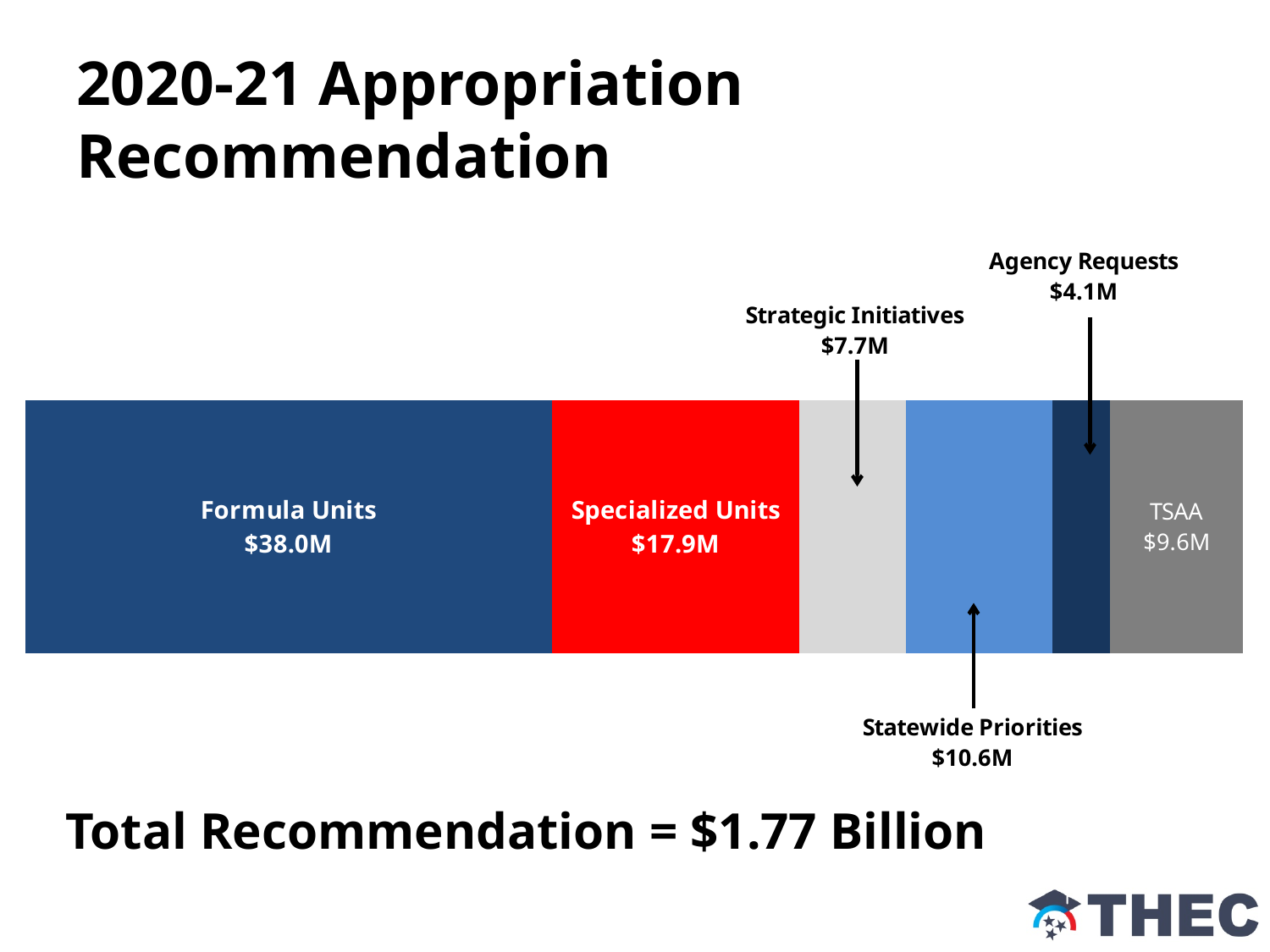
What is the value shown for TSAA? $9.6M What is the value shown for Specialized Units? $17.9M How many segments make up the bar? 6 What kind of chart is shown on the slide? Stacked bar chart Which segment of the bar has the smallest value? Agency Requests What is the value shown for Formula Units? $38.0M What is the value shown for Strategic Initiatives? $7.7M What is the value shown for Agency Requests? $4.1M What is the difference between the Formula Units value and the Specialized Units value? $20.1M Which is larger, Statewide Priorities or TSAA? Statewide Priorities Which segment of the bar has the largest value? Formula Units What is the value shown for Statewide Priorities? $10.6M